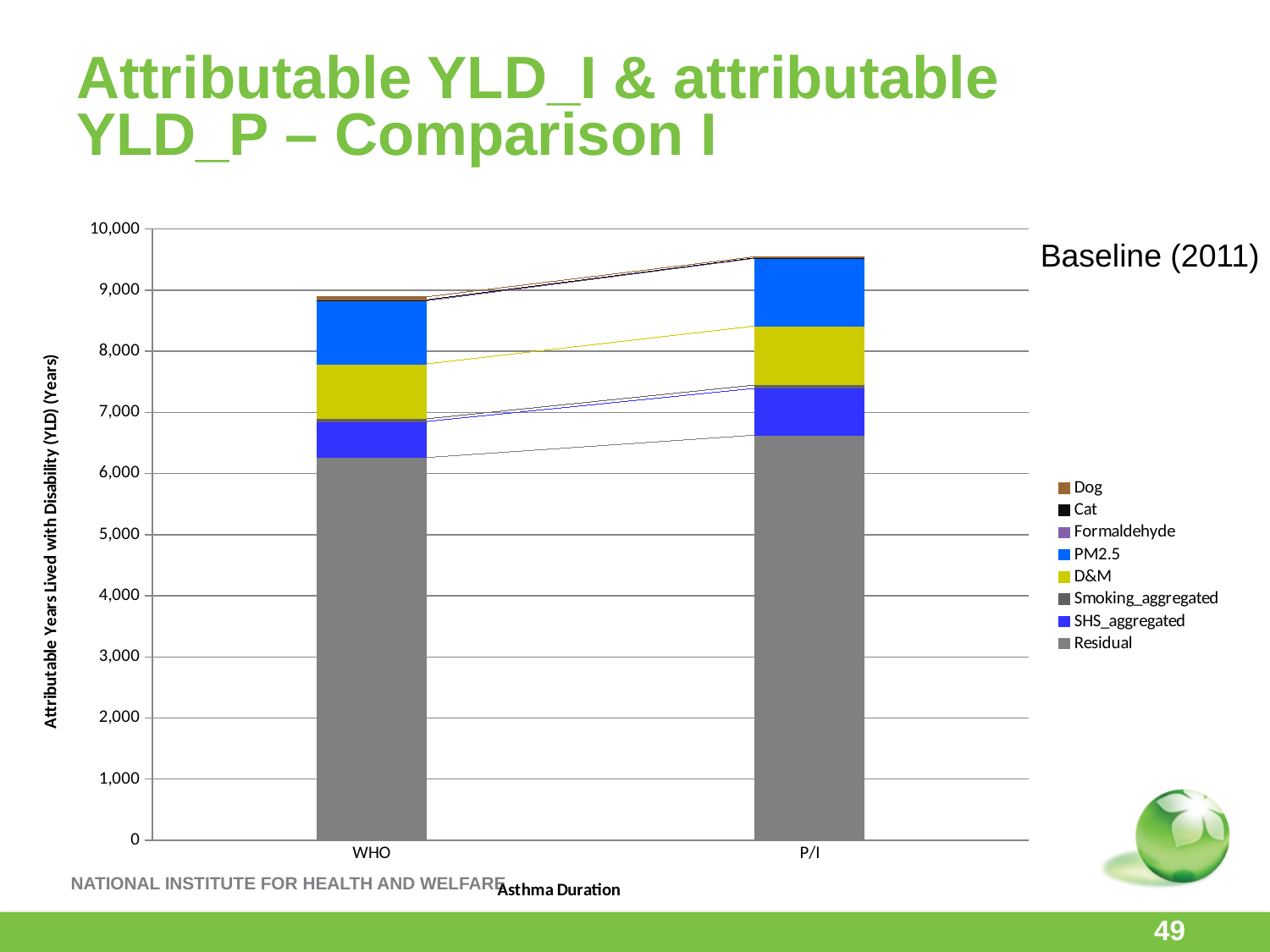
What is the title of the chart's y axis? Attributable Years Lived with Disability (YLD) (Years) How many categories are shown on the x axis of the chart? 2 What is the title of the chart's x axis? Asthma Duration Which category has the taller stacked bar, WHO or P/I? P/I Which category has the highest total attributable YLD? P/I Is the Residual segment for WHO greater or less than 7,000? less Is the total stacked value for WHO greater or less than 8,000? greater Is the total stacked value for P/I greater or less than 9,000? greater What kind of chart is shown on the slide? Stacked bar chart How many series does the chart's legend list? 8